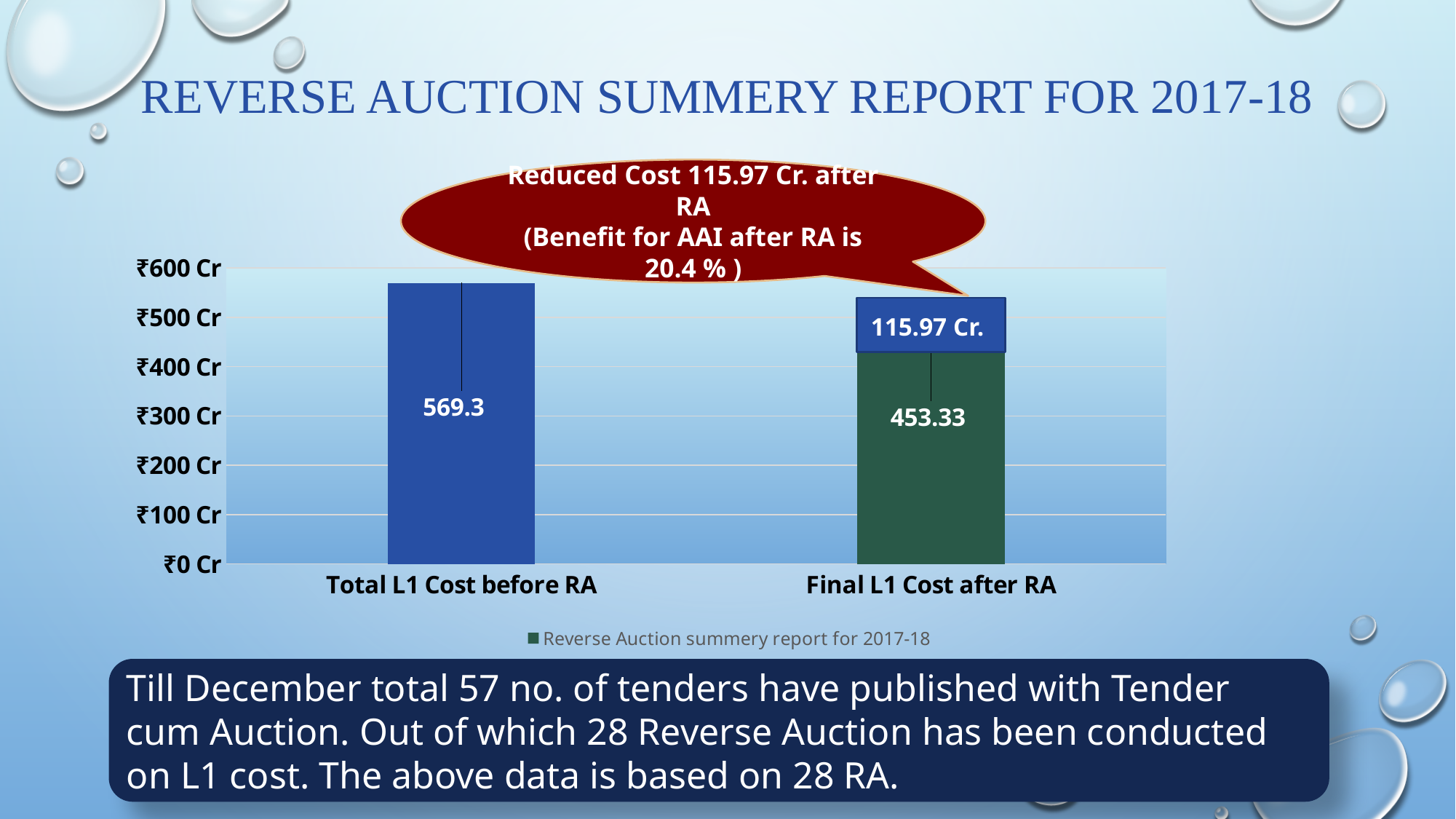
What kind of chart is shown on the slide? bar chart How many categories are shown on the x axis of the chart? 2 What is the value shown on the green portion of the Final L1 Cost after RA bar? 453.33 What text does the chart legend show? Reverse Auction summery report for 2017-18 What is the value shown for Total L1 Cost before RA? 569.3 How many entries does the chart legend list? 1 What is the difference between the Total L1 Cost before RA (569.3) and the Final L1 Cost after RA (453.33)? 115.97 Which category has the higher labelled cost, Total L1 Cost before RA or the green portion of Final L1 Cost after RA? Total L1 Cost before RA Is the value for Total L1 Cost before RA greater or less than ₹500 Cr? greater What is the total of the stacked Final L1 Cost after RA bar (453.33 plus 115.97)? 569.3 Is the green portion of the Final L1 Cost after RA bar greater or less than ₹500 Cr? less What value is labelled on the blue segment stacked on top of the Final L1 Cost after RA bar? 115.97 Cr.